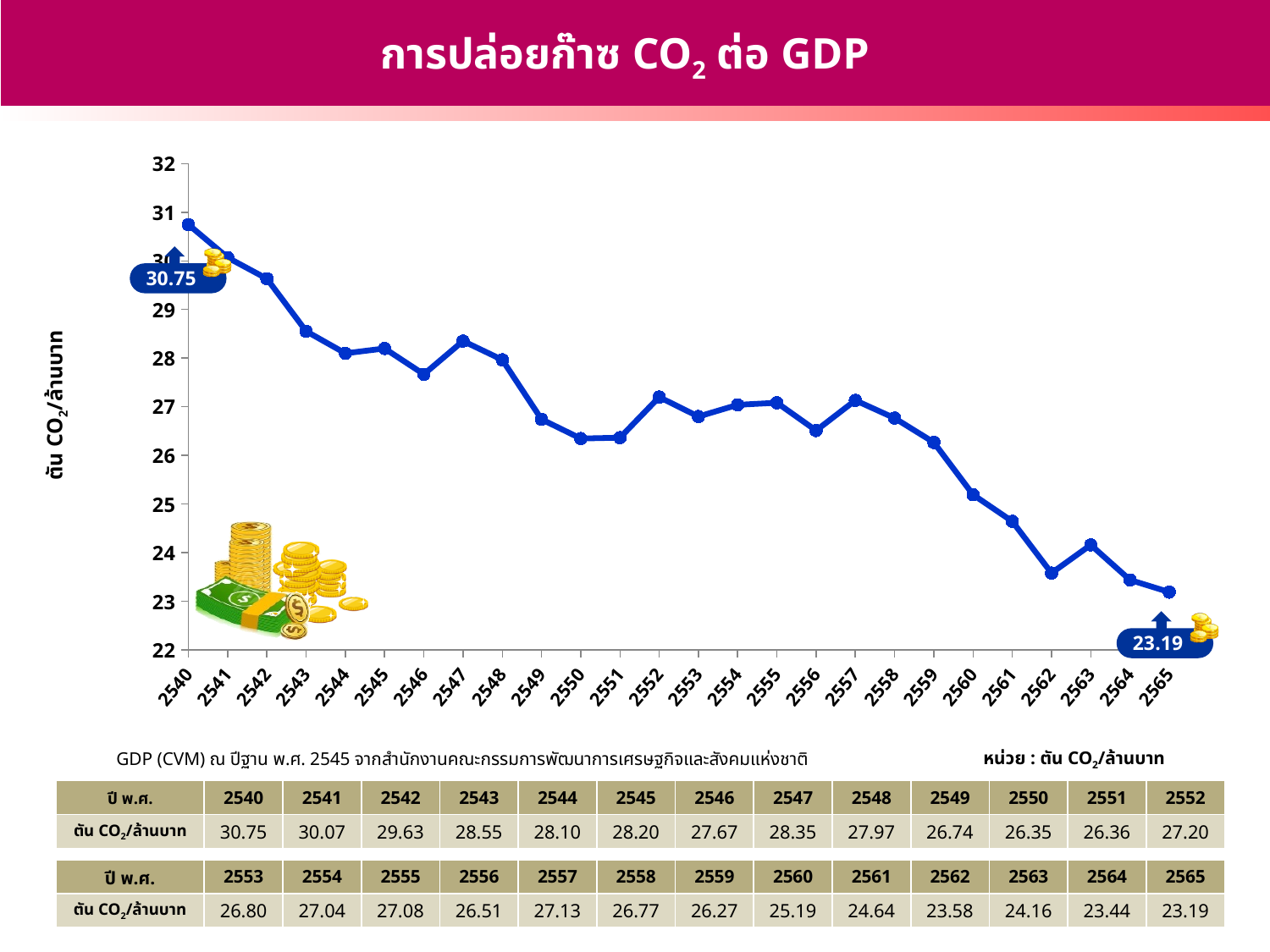
What is the difference between the values for 2563 and 2562? 0.58 Is the value for 2560 greater or less than 26? less What is the value for the year 2552? 27.20 Which year has the highest value on the chart? 2540 What is the difference between the values for 2540 and 2565? 7.56 How many years (data points) are plotted on the chart? 26 Which year has the larger value, 2546 or 2547? 2547 What type of chart is shown on the slide? line chart What is the value of ตัน CO2/ล้านบาท for the year 2540? 30.75 Which year has the lowest value on the chart? 2565 What is the value of ตัน CO2/ล้านบาท for the year 2565? 23.19 What is the value for the year 2563? 24.16